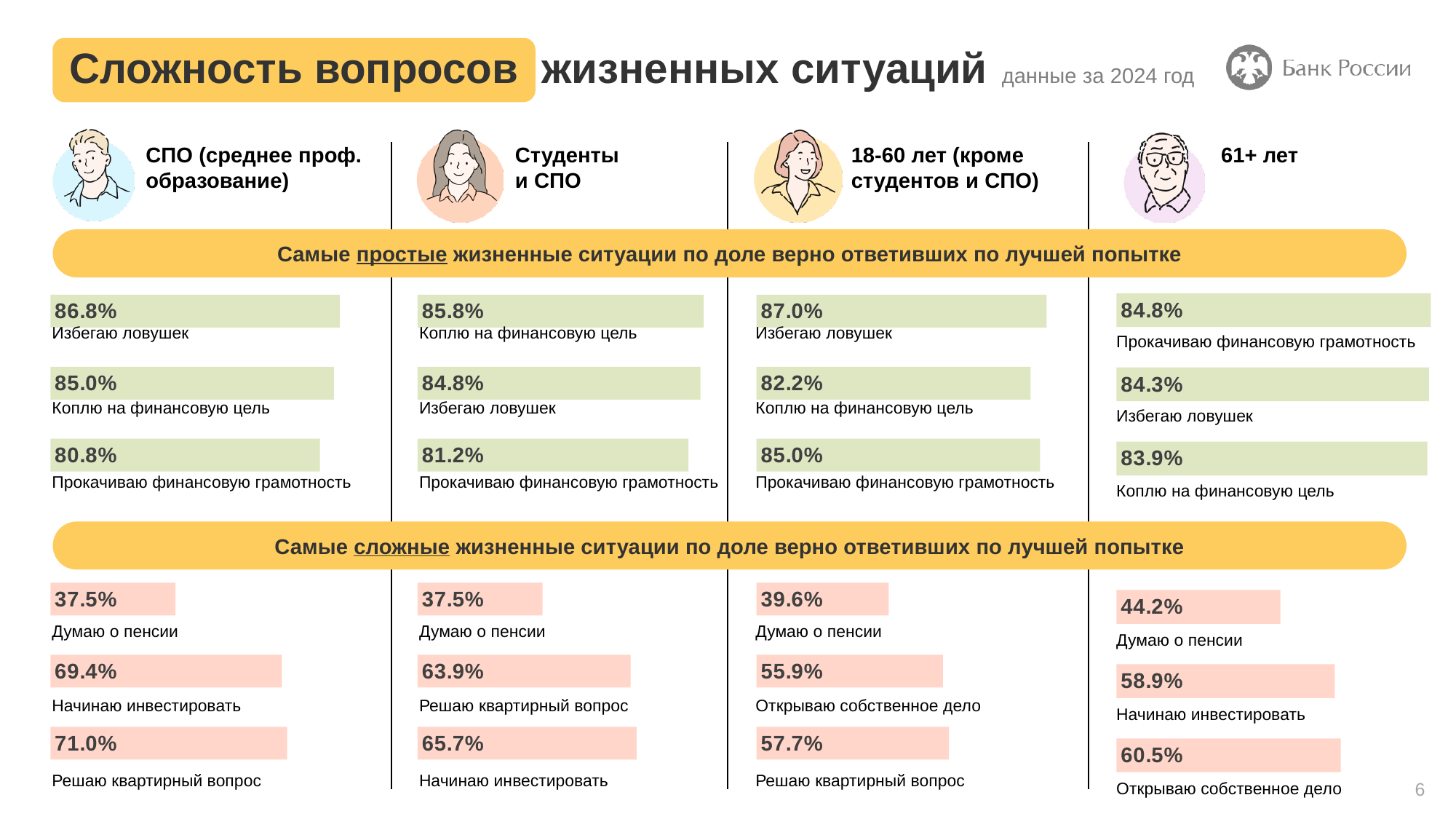
In the 'Самые сложные' section for the Студенты и СПО group, what is the value for 'Решаю квартирный вопрос'? 63.9% In the 'Самые простые' section for the 61+ лет group, which situation has the highest share of correct answers? Прокачиваю финансовую грамотность What kind of chart is used to show the shares in each section of the slide? bar chart In the 'Самые сложные' section for the СПО group, what is the difference between 'Решаю квартирный вопрос' and 'Думаю о пенсии'? 33.5% In the 'Самые сложные' section for the 18-60 лет group, which situation has the lowest share of correct answers? Думаю о пенсии In the 'Самые простые' section for the 18-60 лет group, what is the value for 'Коплю на финансовую цель'? 82.2% In the 'Самые сложные' section for the 61+ лет group, is the value for 'Начинаю инвестировать' greater or less than 50%? greater In the 'Самые простые' section, which is larger: 'Избегаю ловушек' for the СПО group or 'Избегаю ловушек' for the 18-60 лет group? 18-60 лет group How many situations are listed in the 'Самые простые' section for the Студенты и СПО group? 3 In the 'Самые простые' section for the СПО group, what is the value for 'Избегаю ловушек'? 86.8% In the 'Самые сложные' section for the 61+ лет group, what is the value for 'Думаю о пенсии'? 44.2% How many population groups are compared on the slide? 4